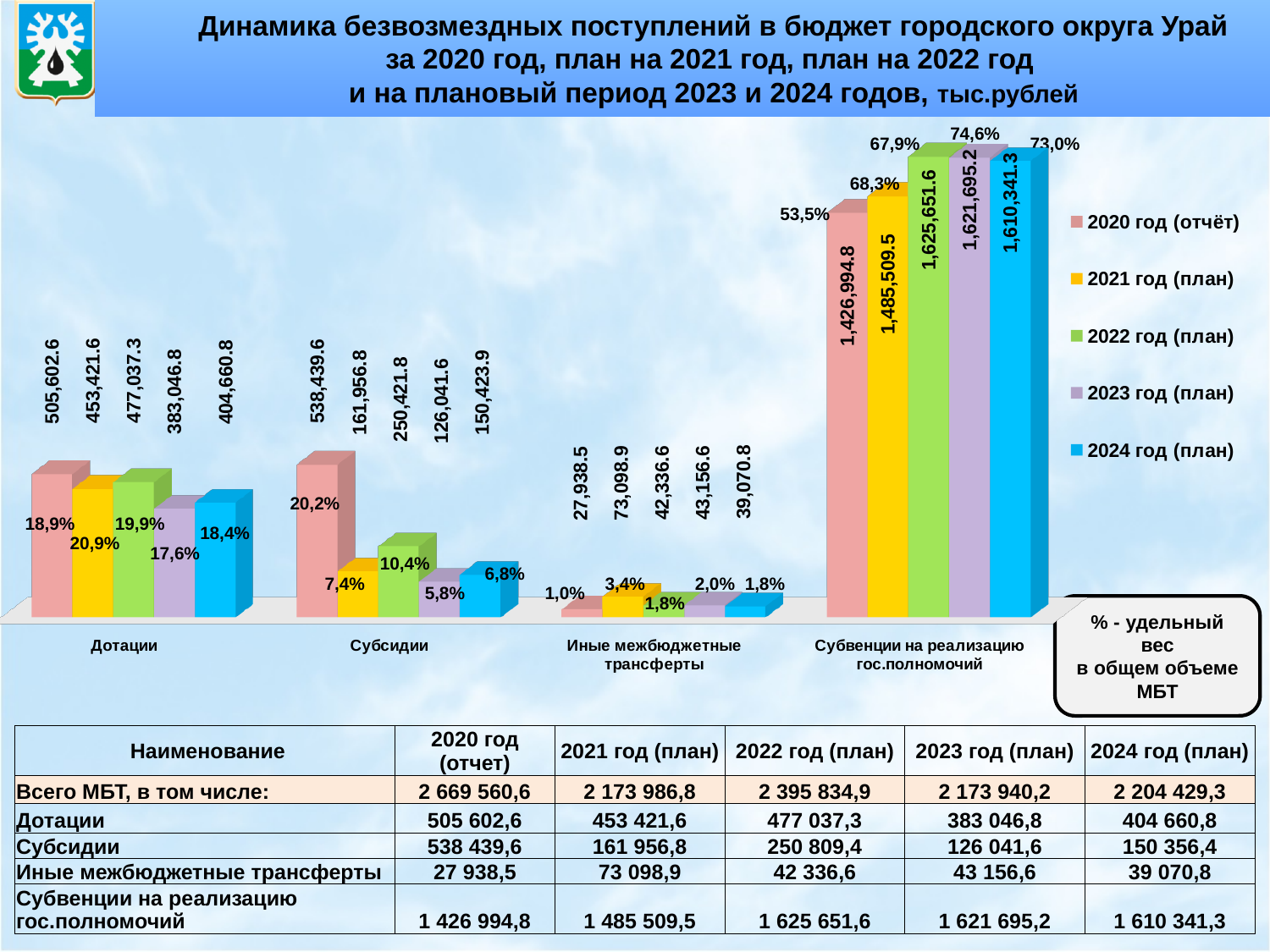
What is the value for Дотации in the 2020 год (отчёт) series? 505,602.6 What is the value for Иные межбюджетные трансферты in the 2021 год (план) series? 73,098.9 What is the value for Субвенции на реализацию гос.полномочий in the 2022 год (план) series? 1,625,651.6 What colour represents the 2024 год (план) series in the chart? Blue How many series does the chart legend list? 5 How many categories are shown on the x axis of the chart? 4 Which series has the highest value for Субвенции на реализацию гос.полномочий? 2022 год (план) Which is larger for Субсидии: the 2020 год (отчёт) value or the 2021 год (план) value? 2020 год (отчёт) What is the difference between the 2020 год (отчёт) and 2021 год (план) values for Дотации? 52,181.0 What kind of chart is shown on the slide? Bar chart What percentage share is shown for Субвенции на реализацию гос.полномочий in the 2023 год (план) series? 74,6% Which series has the lowest value for Дотации? 2023 год (план)